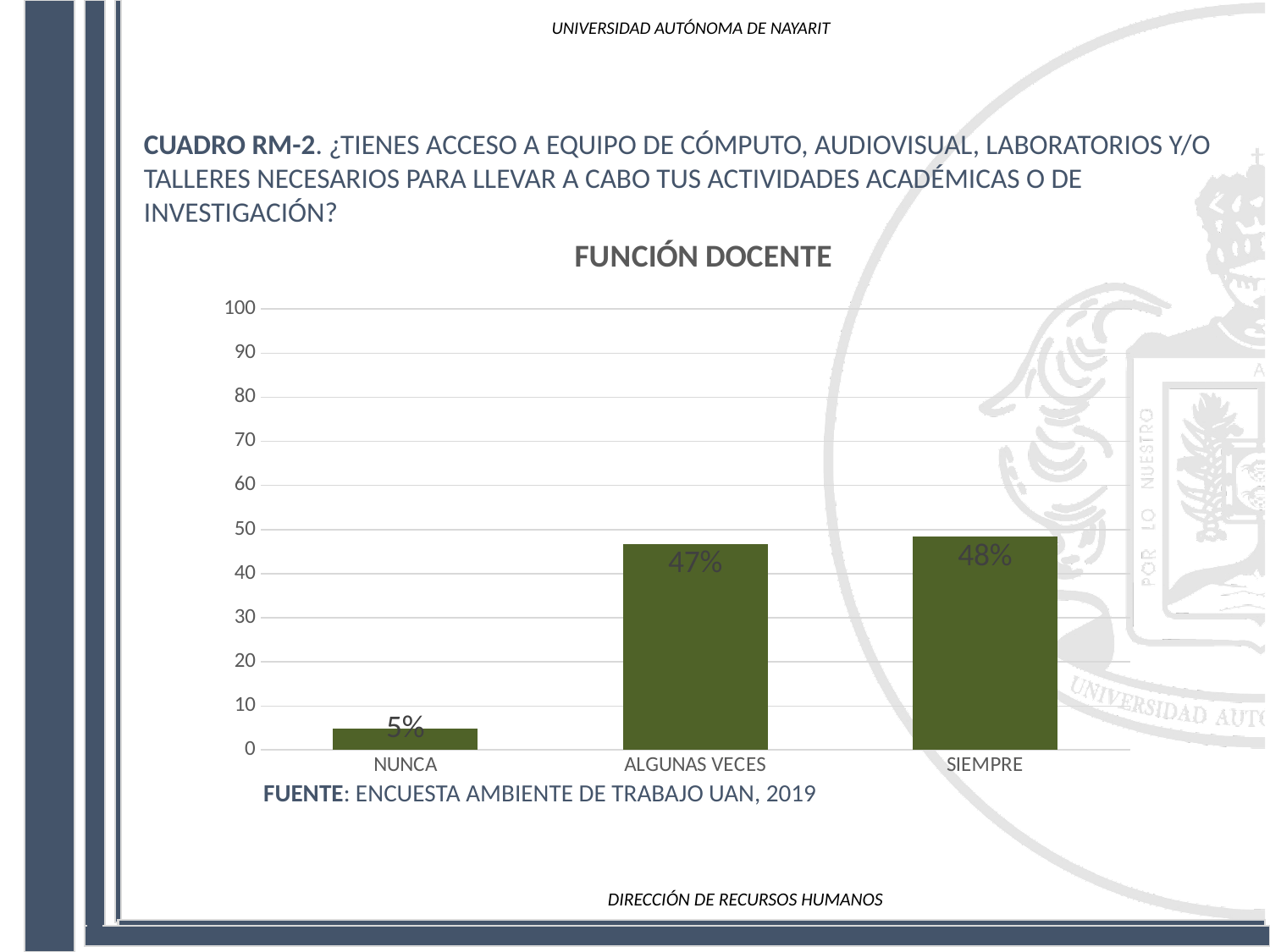
What is the value for NUNCA in the FUNCIÓN DOCENTE chart? 5% Which category has the lowest value in the FUNCIÓN DOCENTE chart? NUNCA What is the value for ALGUNAS VECES in the FUNCIÓN DOCENTE chart? 47% Is the value for SIEMPRE greater or less than 30? greater Which category has the highest value in the FUNCIÓN DOCENTE chart? SIEMPRE How many categories are shown on the x axis of the chart? 3 What is the value for SIEMPRE in the FUNCIÓN DOCENTE chart? 48% What is the title of the chart? FUNCIÓN DOCENTE What kind of chart is shown on the slide? bar chart What is the difference between the values for ALGUNAS VECES and NUNCA? 42 percentage points Which is larger, the value for ALGUNAS VECES or the value for NUNCA? ALGUNAS VECES Is the value for NUNCA greater or less than 10? less